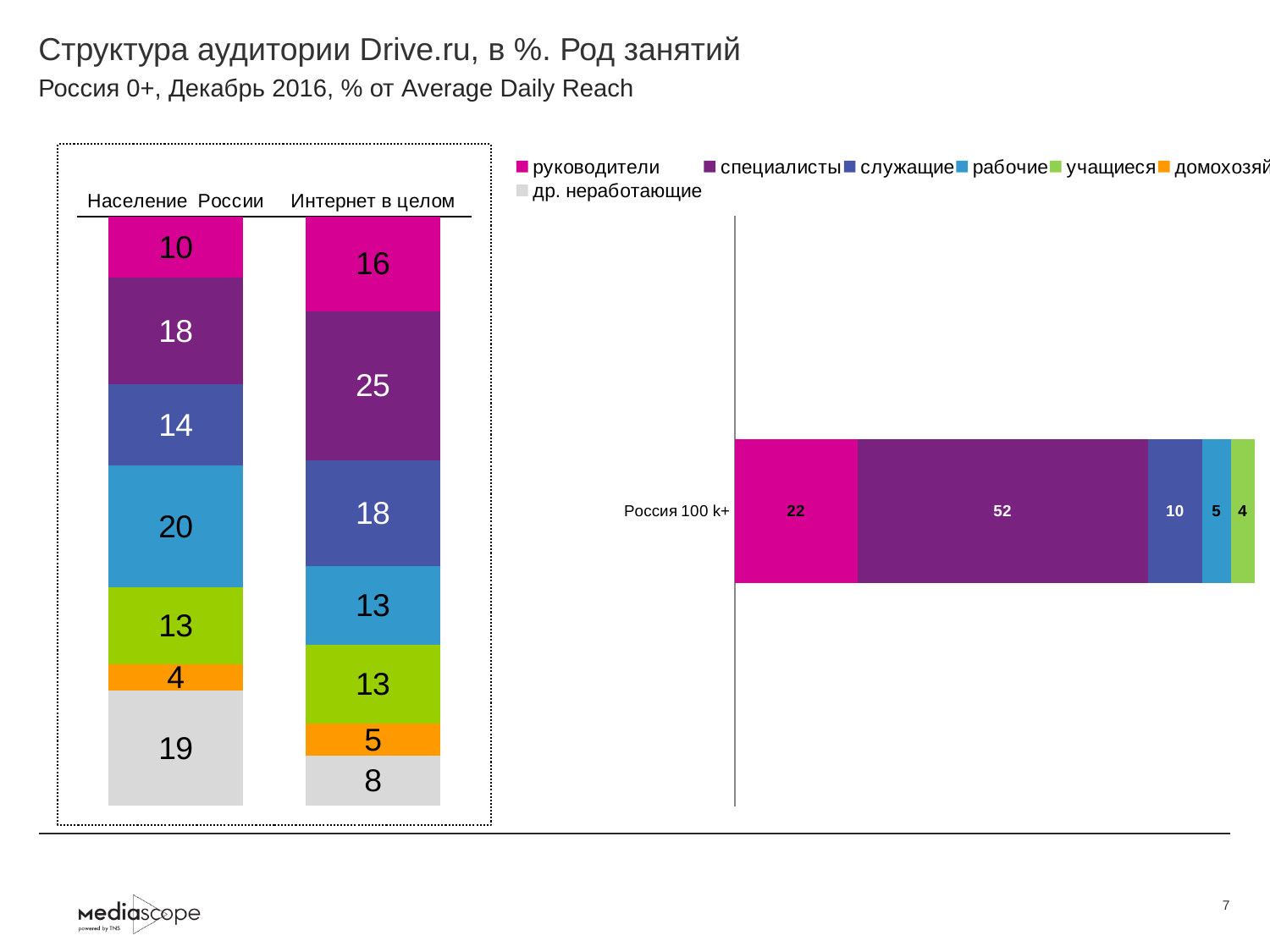
On the left chart, what is the value for специалисты in the Интернет в целом bar? 25 What type of chart is the right chart? stacked bar chart On the right chart, what is the value for руководители in the Россия 100 k+ bar? 22 On the right chart, what is the value for специалисты in the Россия 100 k+ bar? 52 On the left chart, which is larger: др. неработающие for Население России or for Интернет в целом? Население России On the left chart, what is the difference between the специалисты values for Интернет в целом and Население России? 7 On the left chart, what is the value for рабочие in the Население России bar? 20 On the left chart, which segment is the smallest in the Интернет в целом bar? домохозяйки How many bars does the left chart show? 2 On the right chart, which is larger: служащие or рабочие in the Россия 100 k+ bar? служащие On the left chart, which segment is the largest in the Население России bar? рабочие How many series does the legend list? 7